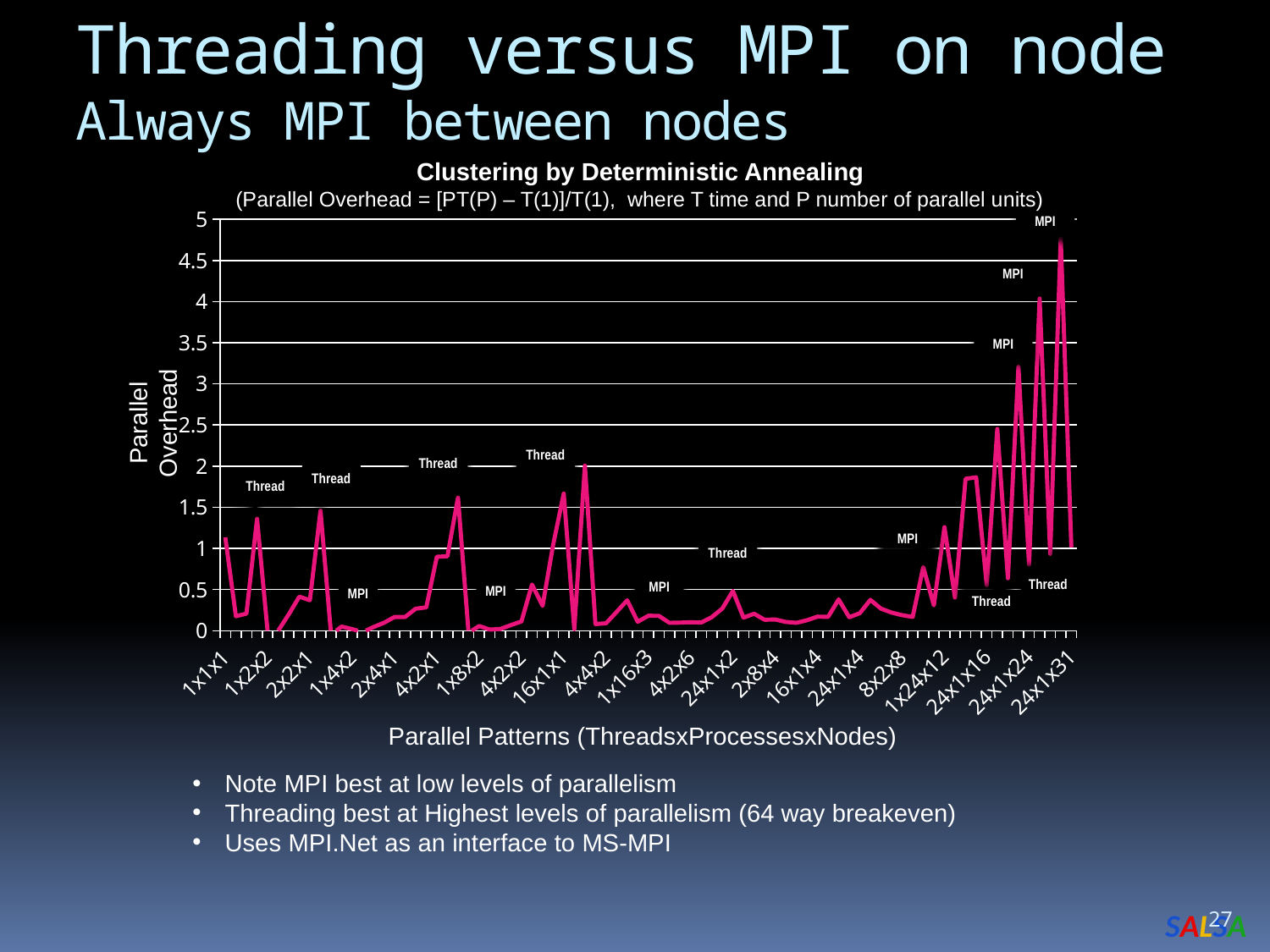
What is the highest value shown on the y axis of the chart? 5 What is the first category label on the x axis of the chart? 1x1x1 Is the highest peak of the line located near the left end or the right end of the x axis? right end What is the label of the chart's x axis? Parallel Patterns (ThreadsxProcessesxNodes) What kind of chart is shown on the slide? line chart What is the last category label on the x axis of the chart? 24x1x31 Is the parallel overhead value for 1x1x1 greater or less than 1.5? less What is the title of the chart? Clustering by Deterministic Annealing How many category labels are printed along the x axis of the chart? 21 Do the peak values of the line generally rise or fall moving from left to right along the x axis? rise Is the highest peak on the chart greater or less than 4.5? greater How many lines (data series) are plotted on the chart? 1